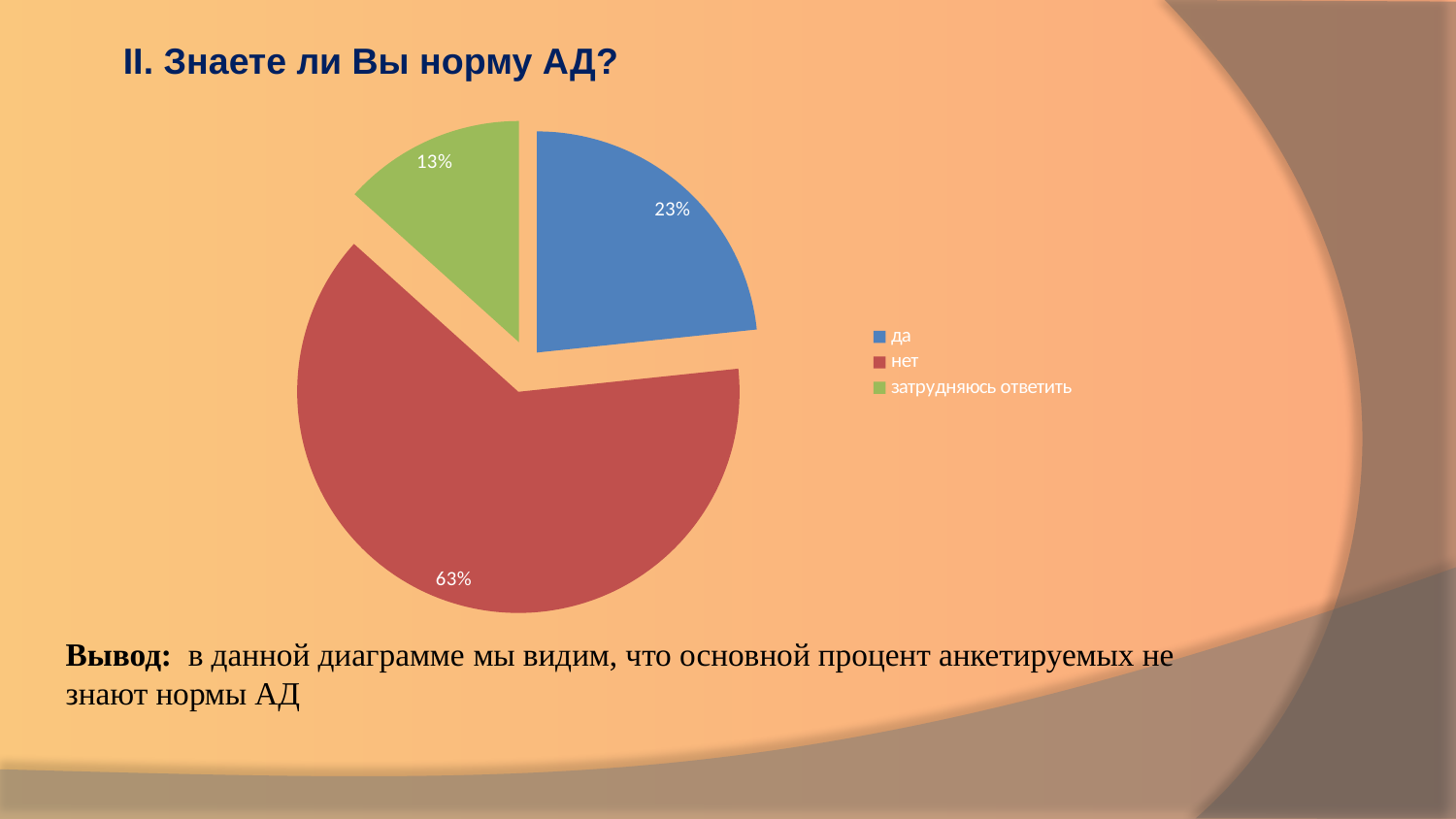
Which answer has the smallest share of the pie? затрудняюсь ответить What percentage of respondents answered "да"? 23% What is the difference in percentage points between "нет" and "да"? 40 Which is larger, the share for "да" or the share for "затрудняюсь ответить"? да What percentage of respondents answered "нет"? 63% How many slices does the pie chart have? 3 What percentage of respondents answered "затрудняюсь ответить"? 13% What colour is the slice for "нет"? red Which answer has the largest share of the pie? нет What type of chart is shown on the slide? pie chart What is the title of the slide above the chart? II. Знаете ли Вы норму АД? How many entries does the legend list? 3